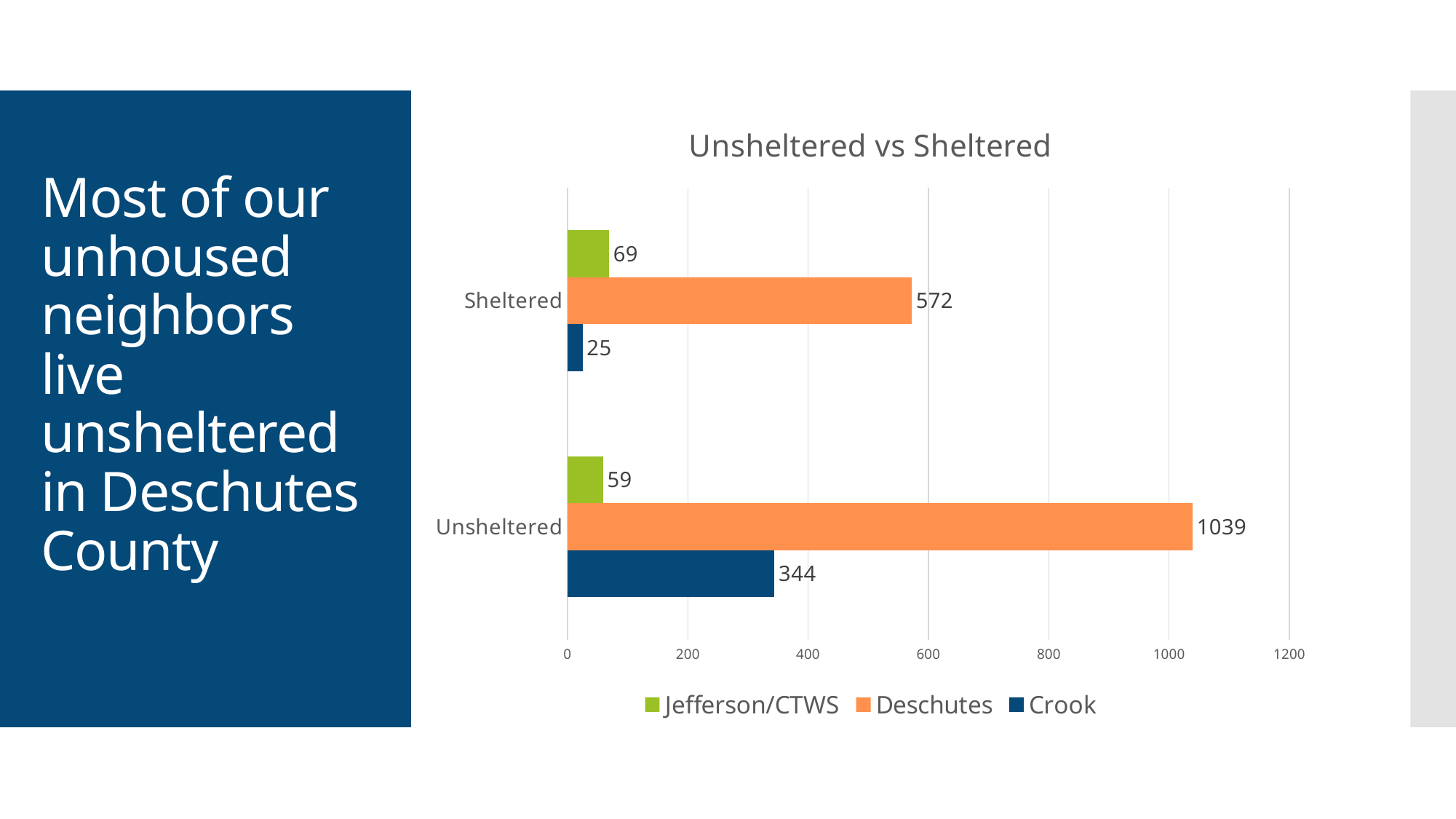
Which series has the lowest value in the Sheltered category? Crook Is the Deschutes Sheltered value greater or less than 600? less What is the difference between the Deschutes Unsheltered and Sheltered values? 467 Which series has the highest value in the Unsheltered category? Deschutes How many series does the legend list? 3 What kind of chart is shown? bar chart What is the Jefferson/CTWS value for Sheltered? 69 Which is larger, the Crook Unsheltered value or the Crook Sheltered value? Crook Unsheltered How many categories are shown on the vertical axis? 2 What is the title of the chart? Unsheltered vs Sheltered What is the Crook value for Sheltered? 25 What is the Deschutes value for Unsheltered? 1039